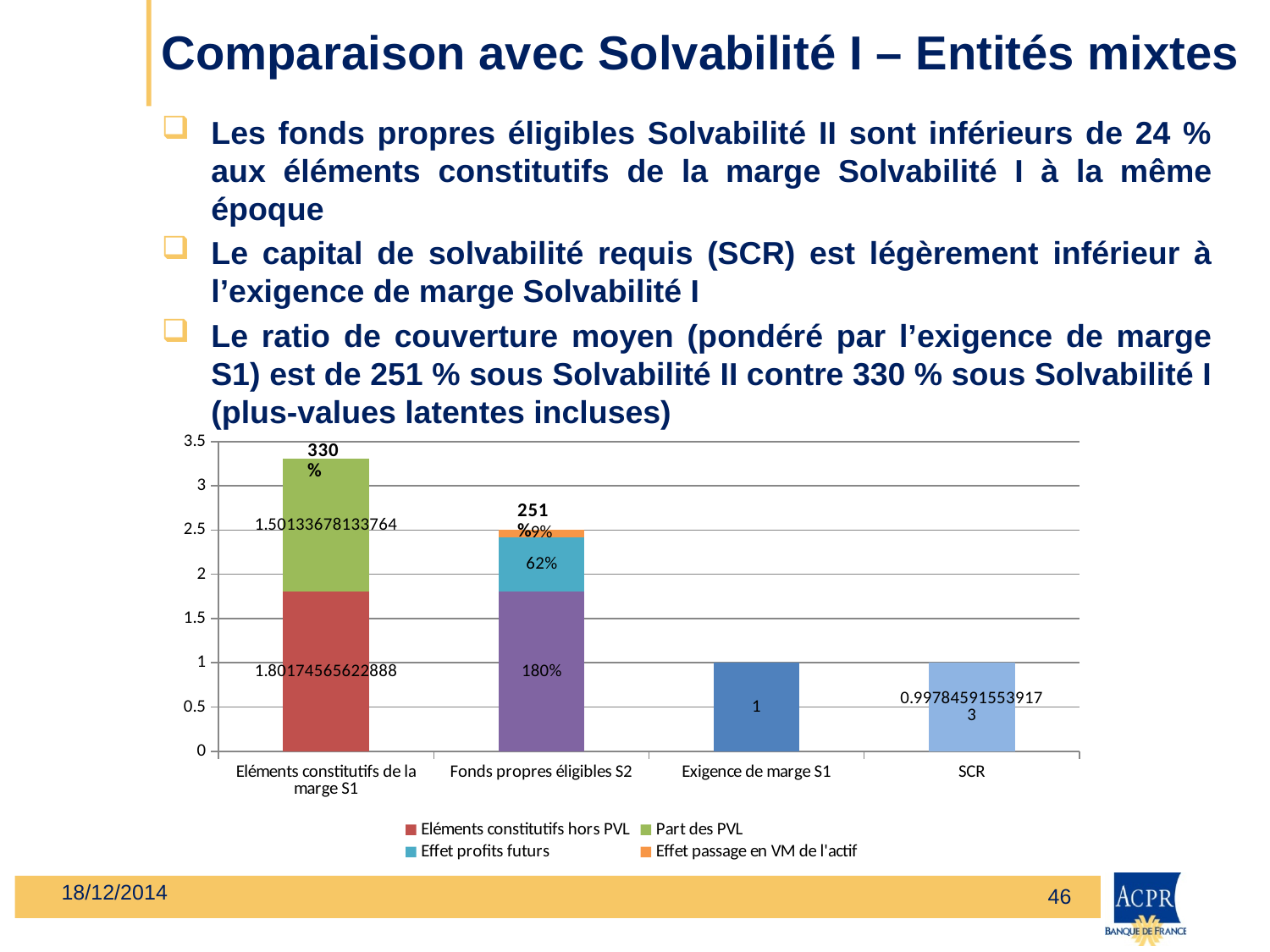
Is the total height of the Eléments constitutifs de la marge S1 bar greater or less than 3? greater What value is labelled on the bar for SCR? 0.997845915539173 Which bar is taller: Eléments constitutifs de la marge S1 or Fonds propres éligibles S2? Eléments constitutifs de la marge S1 Which category has the tallest bar in the chart? Eléments constitutifs de la marge S1 What percentage label is shown above the Eléments constitutifs de la marge S1 bar? 330 % What kind of chart is shown on the slide? Bar chart What value is labelled on the bar for Exigence de marge S1? 1 How many categories are shown on the x axis of the chart? 4 How many series does the chart legend list? 4 What is the labelled value of the Effet profits futurs segment in the Fonds propres éligibles S2 bar? 62% What is the labelled value of the Eléments constitutifs hors PVL segment in the Eléments constitutifs de la marge S1 bar? 1.80174565622888 What is the labelled value of the Part des PVL segment in the Eléments constitutifs de la marge S1 bar? 1.50133678133764